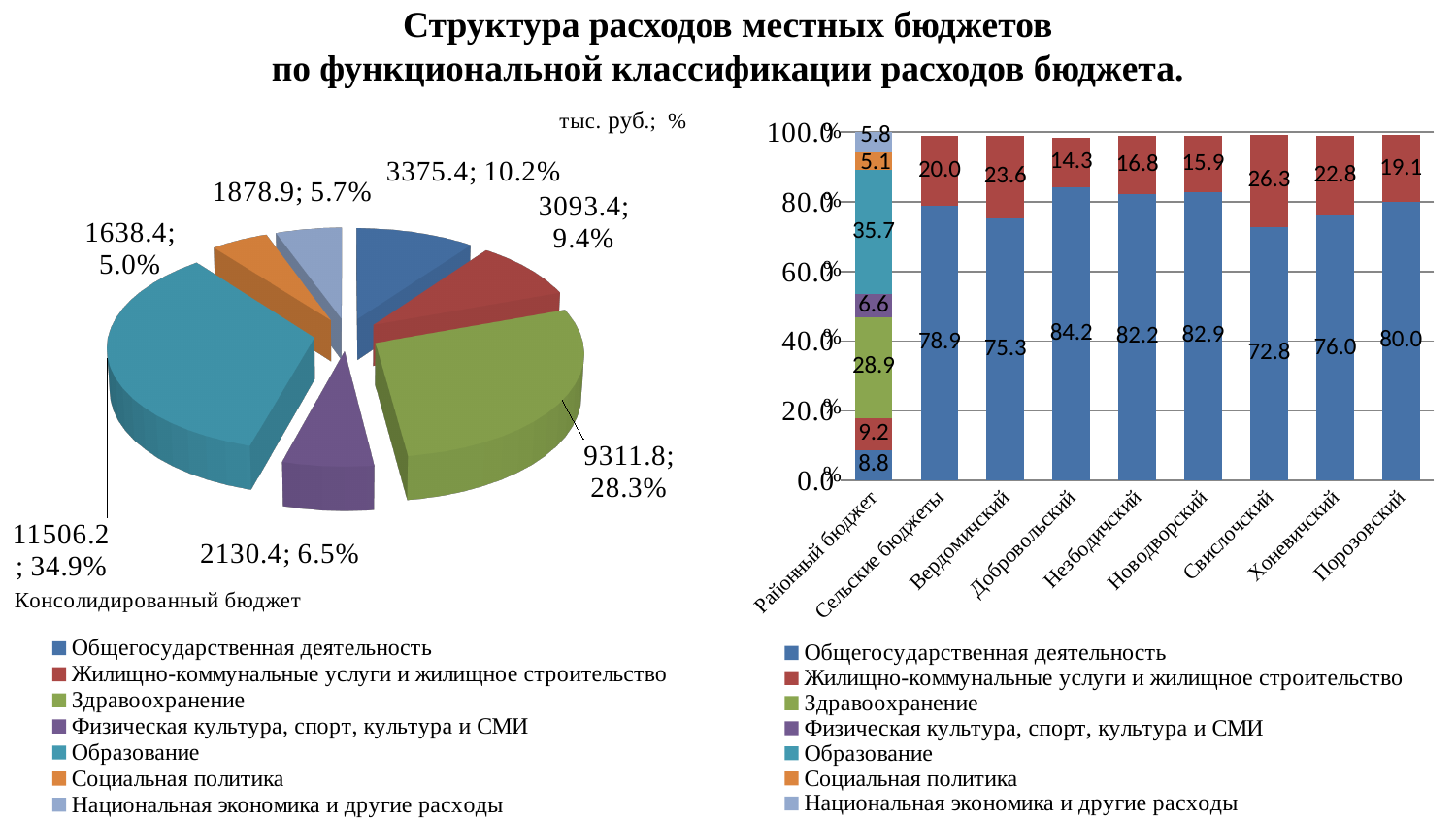
In the bar chart on the right, what is the value of Образование for Районный бюджет? 35.7 In the bar chart on the right, what is the value of Жилищно-коммунальные услуги и жилищное строительство for Свислочский? 26.3 In the pie chart on the left, how many slices are there? 7 In the pie chart on the left, which category has the smallest slice? Социальная политика In the pie chart on the left, what value is shown for Образование? 11506.2; 34.9% In the bar chart on the right, which is larger: the Общегосударственная деятельность value for Хоневичский or for Порозовский? Порозовский In the bar chart on the right, which category has the highest value for Общегосударственная деятельность? Добровольский In the pie chart on the left, what share of the pie does Здравоохранение take? 28.3% In the bar chart on the right, what is the value of Общегосударственная деятельность for Добровольский? 84.2 In the pie chart on the left, what is the difference between the values for Общегосударственная деятельность and Жилищно-коммунальные услуги и жилищное строительство (in тыс. руб.)? 282.0 What type of chart is shown on the right side of the slide? Stacked bar chart In the pie chart on the left, which category has the largest slice? Образование